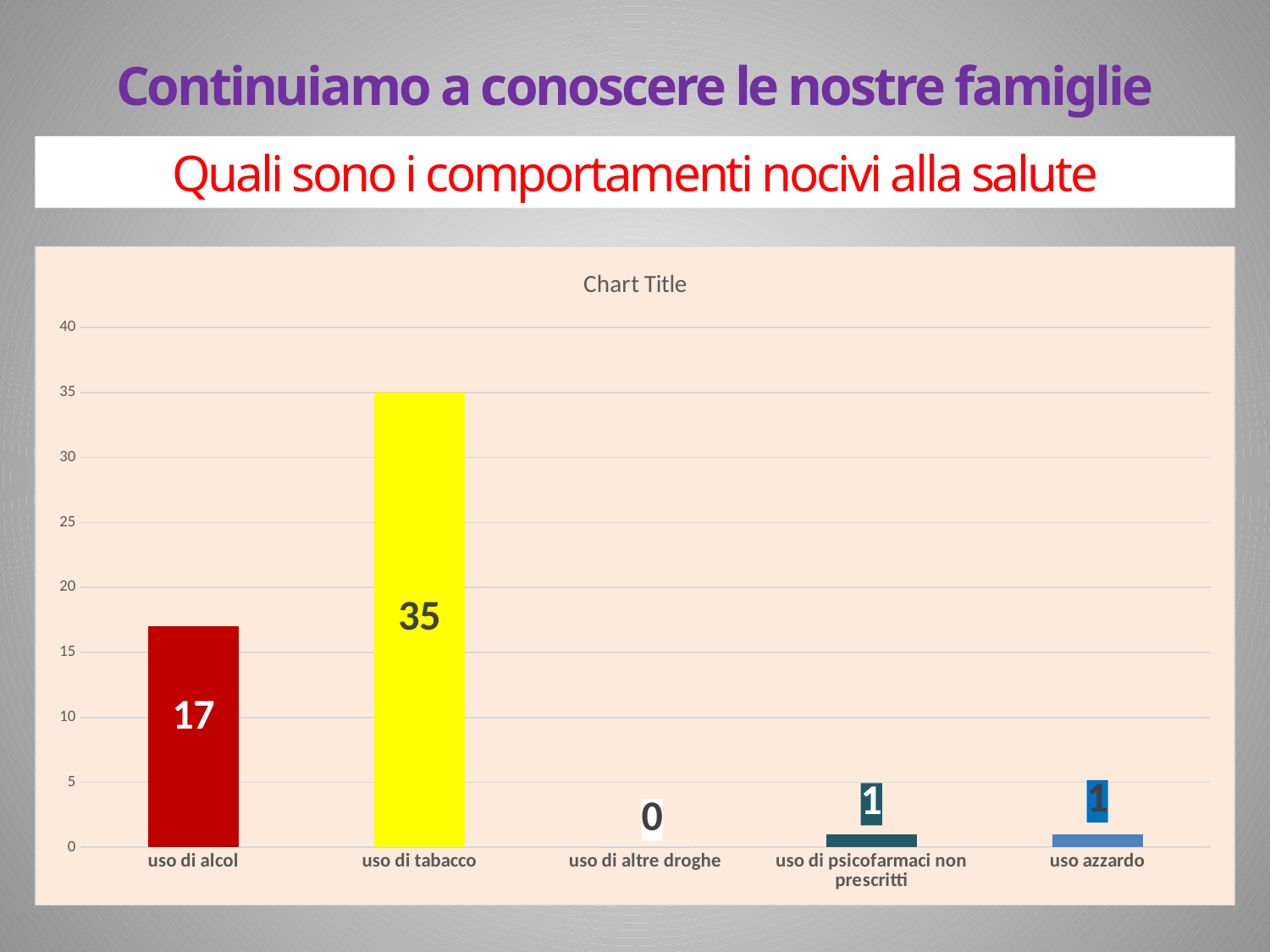
Which category has the highest value? uso di tabacco What is the value for uso di tabacco? 35 What kind of chart is shown on the slide? bar chart Which category has the lowest value? uso di altre droghe Which is larger, the value for uso di alcol or the value for uso azzardo? uso di alcol What is the value for uso di psicofarmaci non prescritti? 1 What is the difference between the values for uso di tabacco and uso di alcol? 18 What colour is the bar for uso di tabacco? yellow How many categories are shown on the x axis? 5 What is the value for uso di altre droghe? 0 What is the value for uso di alcol? 17 Is the value for uso di tabacco greater or less than 30? greater